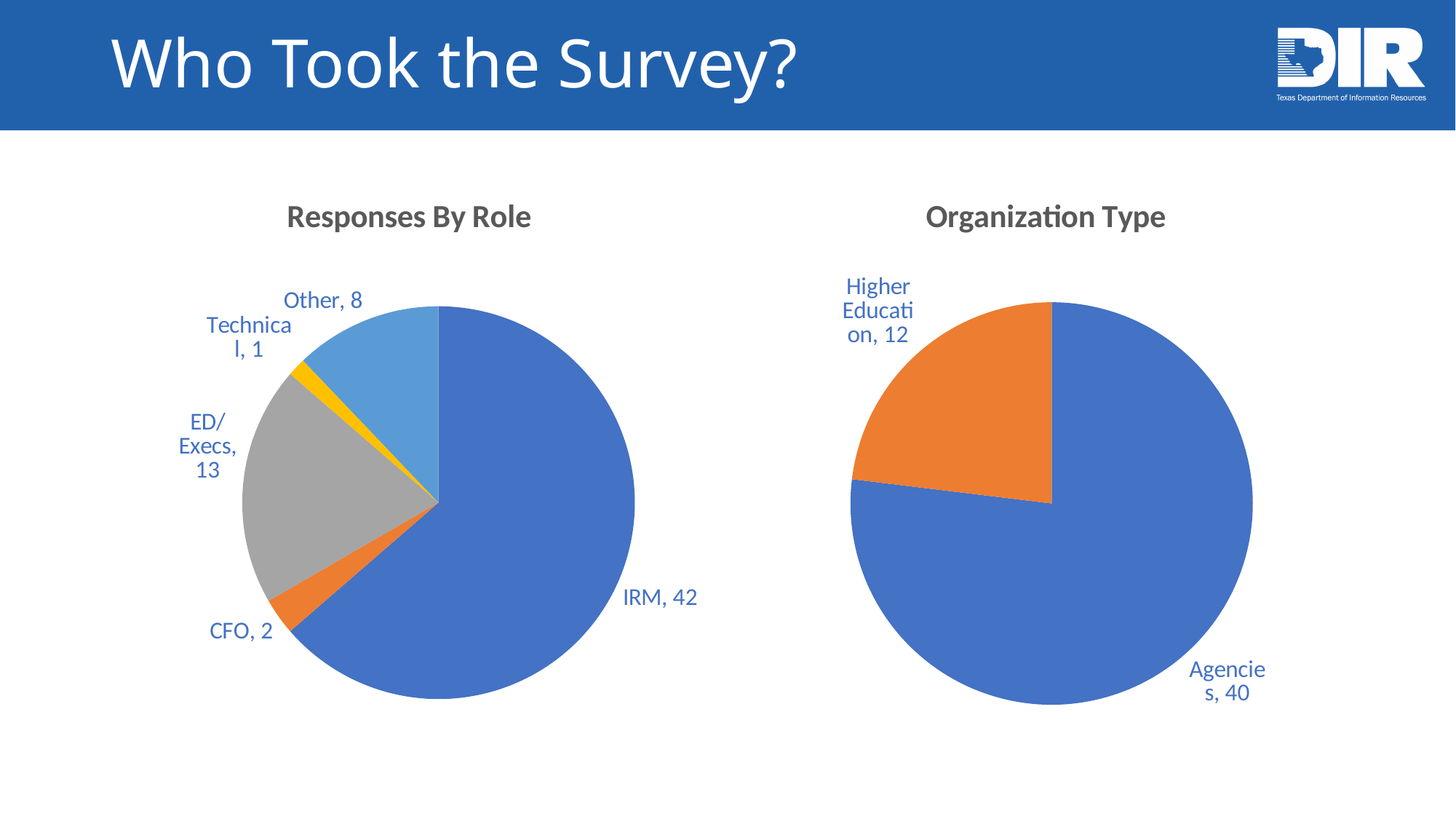
In the Organization Type chart, what share of responses came from Higher Education, to the nearest whole percent? 23% In the Organization Type chart, how many responses came from Higher Education? 12 In the Responses By Role chart, how many responses came from IRMs? 42 In the Responses By Role chart, how many responses came from ED/Execs? 13 In the Organization Type chart, what is the difference between Agencies and Higher Education? 28 In the Responses By Role chart, which has more responses, CFO or Other? Other How many role categories are shown in the Responses By Role chart? 5 In the Responses By Role chart, which role has the fewest responses? Technical In the Responses By Role chart, which role has the most responses? IRM In the Responses By Role chart, what is the difference between the IRM and ED/Execs response counts? 29 What is the total number of responses across all roles in the Responses By Role chart? 66 What type of chart is the Organization Type chart? Pie chart